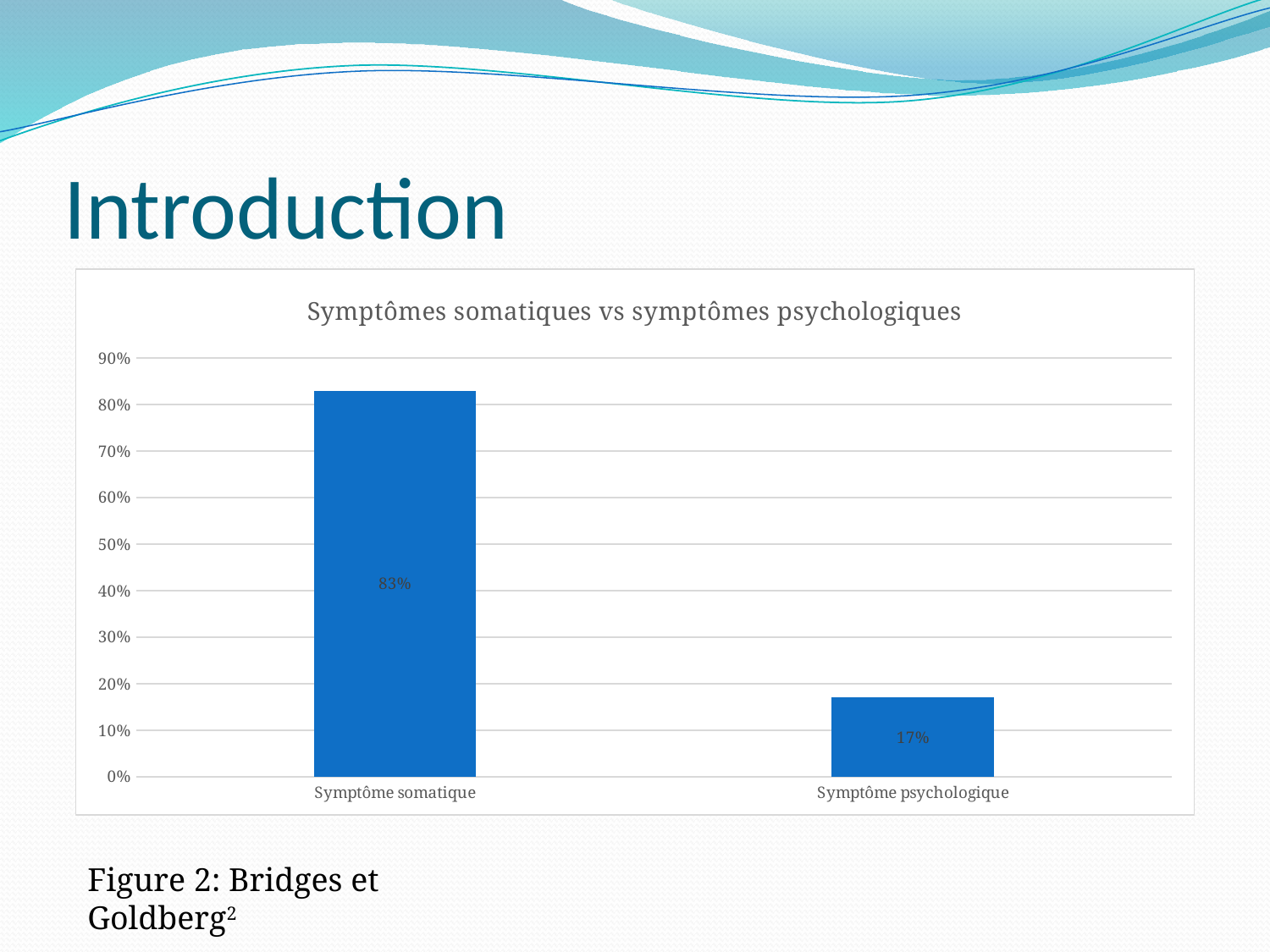
What is the title of the chart? Symptômes somatiques vs symptômes psychologiques What kind of chart is shown on the slide? Bar chart Is the value for Symptôme somatique greater or less than 80%? greater What is the highest value shown on the y axis? 90% Which is larger, the value for Symptôme somatique or the value for Symptôme psychologique? Symptôme somatique Which category has the lowest value? Symptôme psychologique Which category has the highest value? Symptôme somatique Is the value for Symptôme psychologique greater or less than 20%? less What is the value for Symptôme psychologique? 17% How many categories are shown on the x axis? 2 What is the value for Symptôme somatique? 83% What is the difference between the values for Symptôme somatique and Symptôme psychologique? 66%